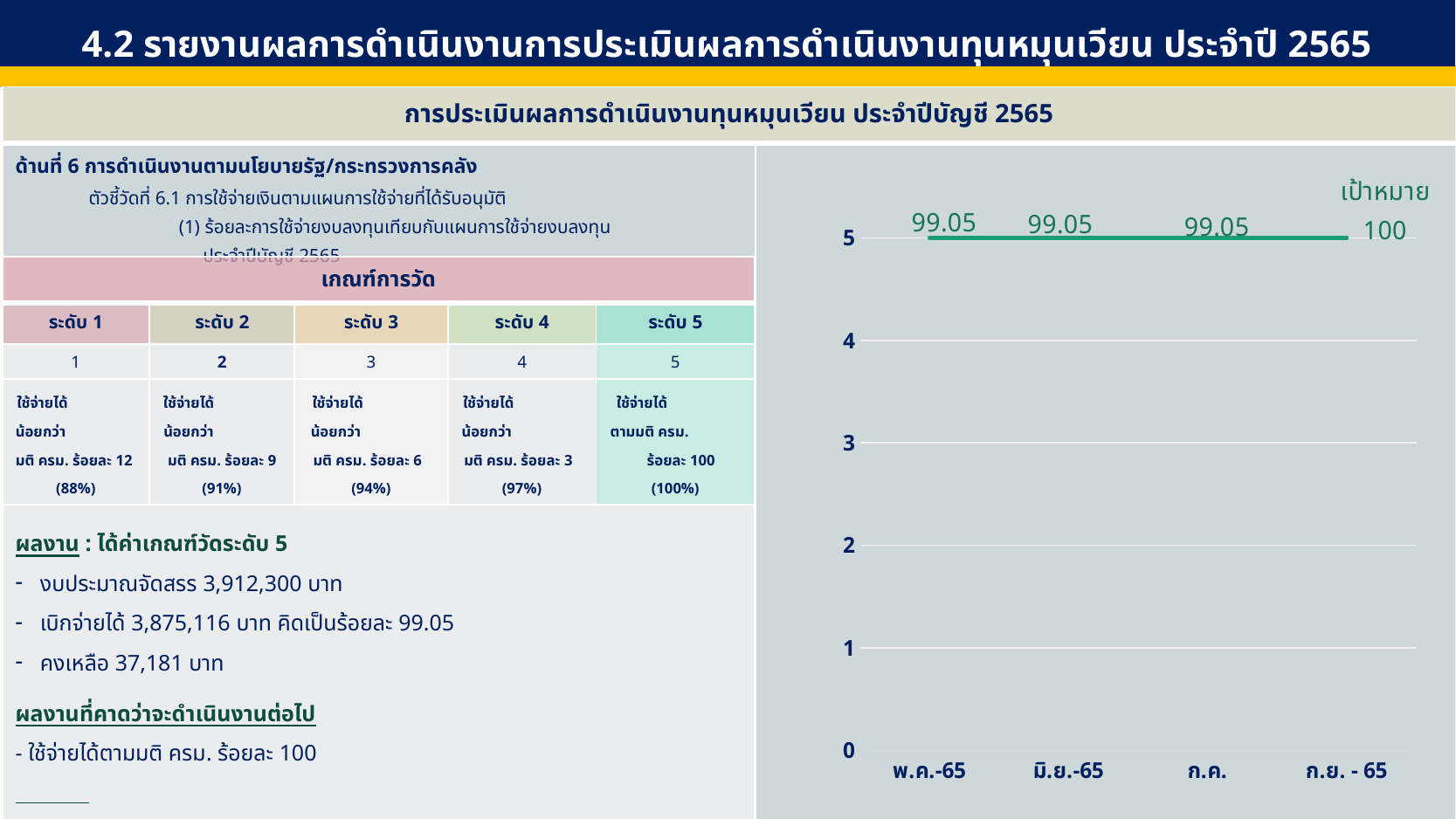
What data label is shown for มิ.ย.-65 in the chart? 99.05 Which has the larger data label in the chart, ก.ค. or ก.ย. - 65? ก.ย. - 65 What is the difference between the data label for ก.ย. - 65 and the data label for ก.ค. in the chart? 0.95 What word is written above the last point of the chart, next to the value 100? เป้าหมาย Which category has the highest data label in the chart? ก.ย. - 65 What data label is shown for ก.ย. - 65 in the chart? 100 What is the highest tick value shown on the y axis of the chart? 5 How many categories are shown on the x axis of the chart? 4 What data label is shown for พ.ค.-65 in the chart? 99.05 Do the data labels change from พ.ค.-65 to ก.ค. in the chart? No, they stay at 99.05 What kind of chart is shown on the right side of the slide? line chart Is the plotted line for พ.ค.-65 greater or less than the 4 gridline on the y axis? greater